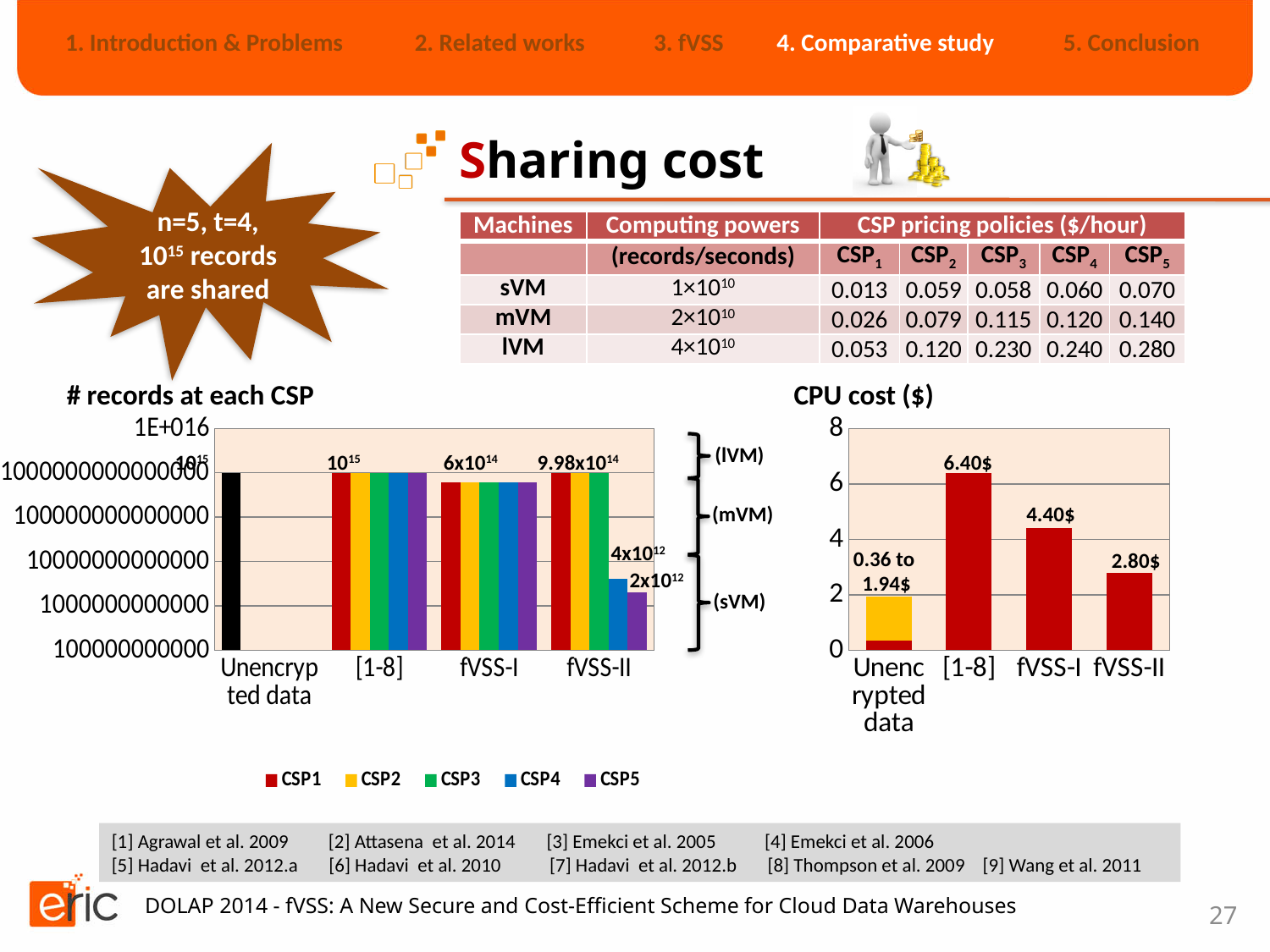
In the CPU cost ($) chart, is the CPU cost for fVSS-II greater or less than 4? less In the CPU cost ($) chart, which has a higher CPU cost, fVSS-I or fVSS-II? fVSS-I In the CPU cost ($) chart, what is the difference between the CPU cost of [1-8] and fVSS-I? 2.00$ In the CPU cost ($) chart, what is the CPU cost for fVSS-I? 4.40$ In the # records at each CSP chart, what is the labelled number of records at each CSP for fVSS-I? 6x10^14 What kind of chart is the CPU cost ($) chart? bar chart In the # records at each CSP chart, what is the labelled number of records for CSP5 under fVSS-II? 2x10^12 In the CPU cost ($) chart, which category has the highest CPU cost? [1-8] In the CPU cost ($) chart, what is the CPU cost for fVSS-II? 2.80$ In the CPU cost ($) chart, what is the CPU cost for [1-8]? 6.40$ How many categories are shown on the x axis of the CPU cost ($) chart? 4 How many series does the legend of the # records at each CSP chart list? 5